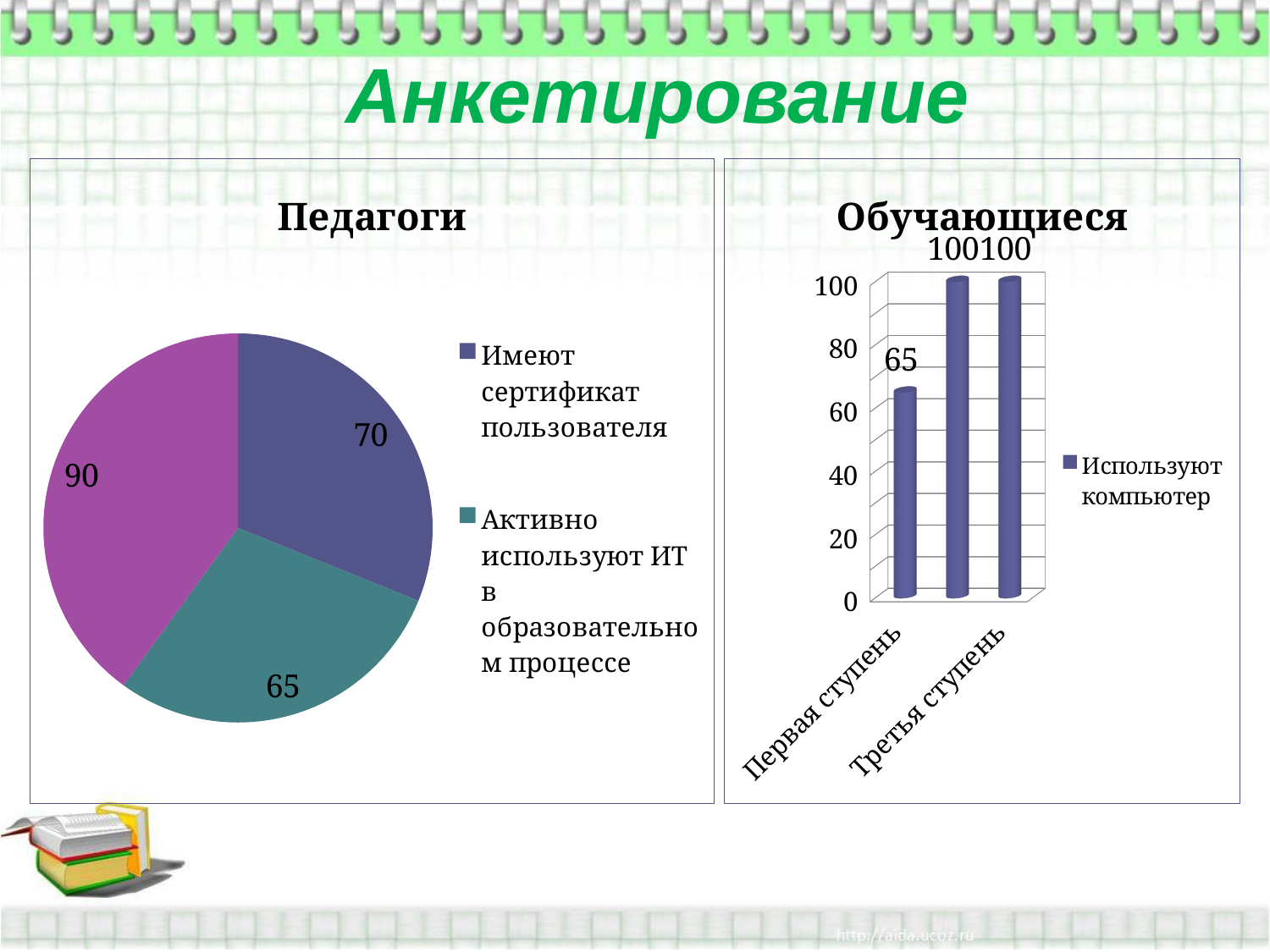
In the bar chart titled Обучающиеся, what series name does the legend show? Используют компьютер In the bar chart titled Обучающиеся, what is the difference between the values for Третья ступень and Первая ступень? 35 In the bar chart titled Обучающиеся, how many bars are plotted? 3 In the pie chart titled Педагоги, what is the smallest value labelled on any slice? 65 In the bar chart titled Обучающиеся, what is the value for Первая ступень? 65 In the pie chart titled Педагоги, what share of the total do the three slices' values give to the slice labelled 90? 40% What kind of chart is the chart titled Педагоги? Pie chart In the bar chart titled Обучающиеся, what is the value for Третья ступень? 100 In the pie chart titled Педагоги, what is the difference between the largest slice value (90) and the slice for Активно используют ИТ в образовательном процессе? 25 In the pie chart titled Педагоги, what value is shown for the slice Имеют сертификат пользователя? 70 In the pie chart titled Педагоги, what is the largest value labelled on any slice? 90 In the pie chart titled Педагоги, what value is shown for the slice Активно используют ИТ в образовательном процессе? 65